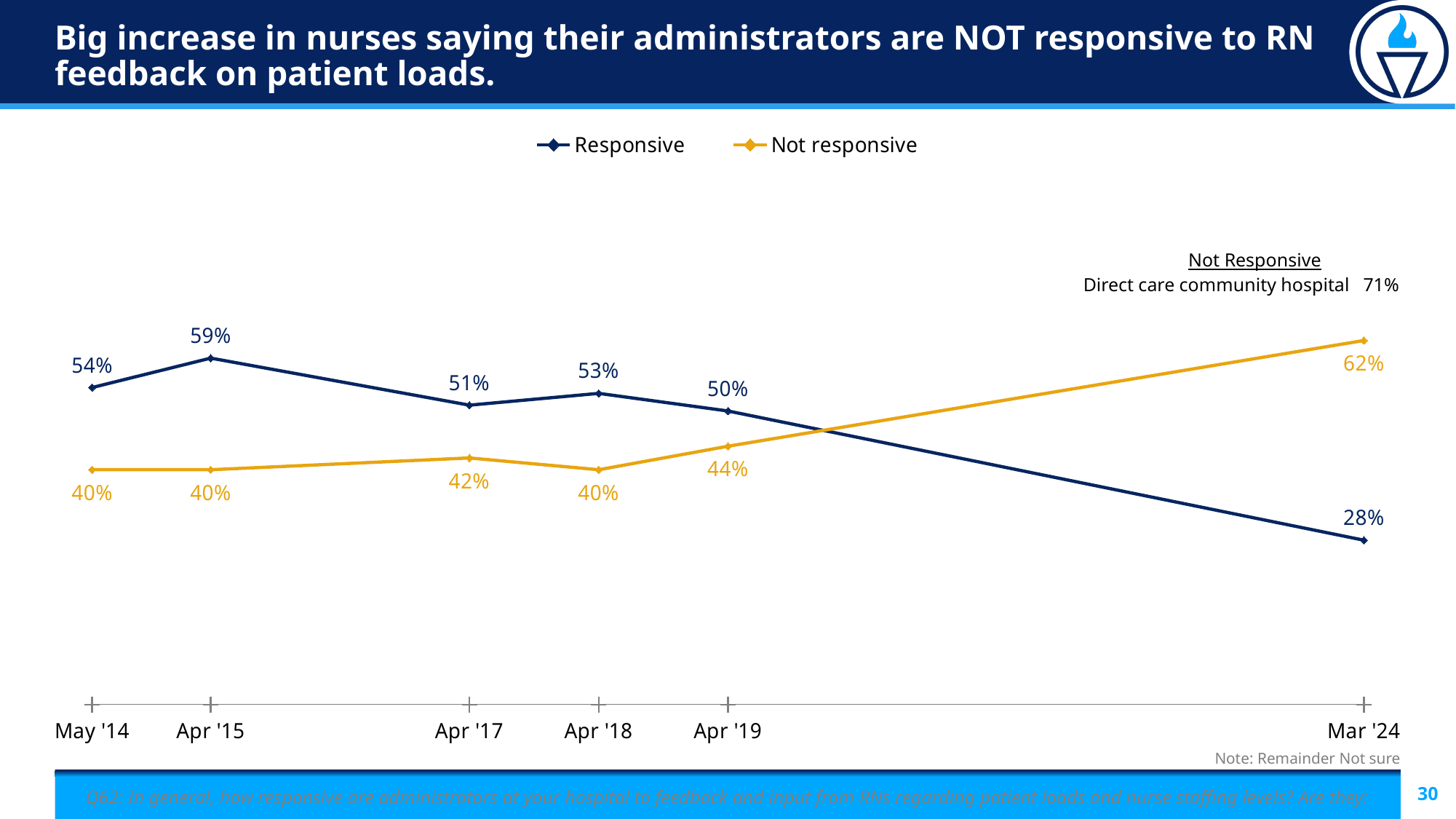
What is the value for Not responsive in Apr '19? 44% At which time point is the Responsive series lowest? Mar '24 What is the value for Responsive in Apr '15? 59% What is the difference between Not responsive and Responsive in Mar '24? 34% How many series does the legend list? 2 What is the value for Not responsive in Mar '24? 62% What kind of chart is shown on the slide? Line chart In Apr '18, which series has the larger value, Responsive or Not responsive? Responsive At which time point is the Responsive series highest? Apr '15 How many time points are plotted on the x axis? 6 Does the Not responsive series rise or fall from Apr '18 to Mar '24? Rise What colour is the line for the Not responsive series? Yellow/gold